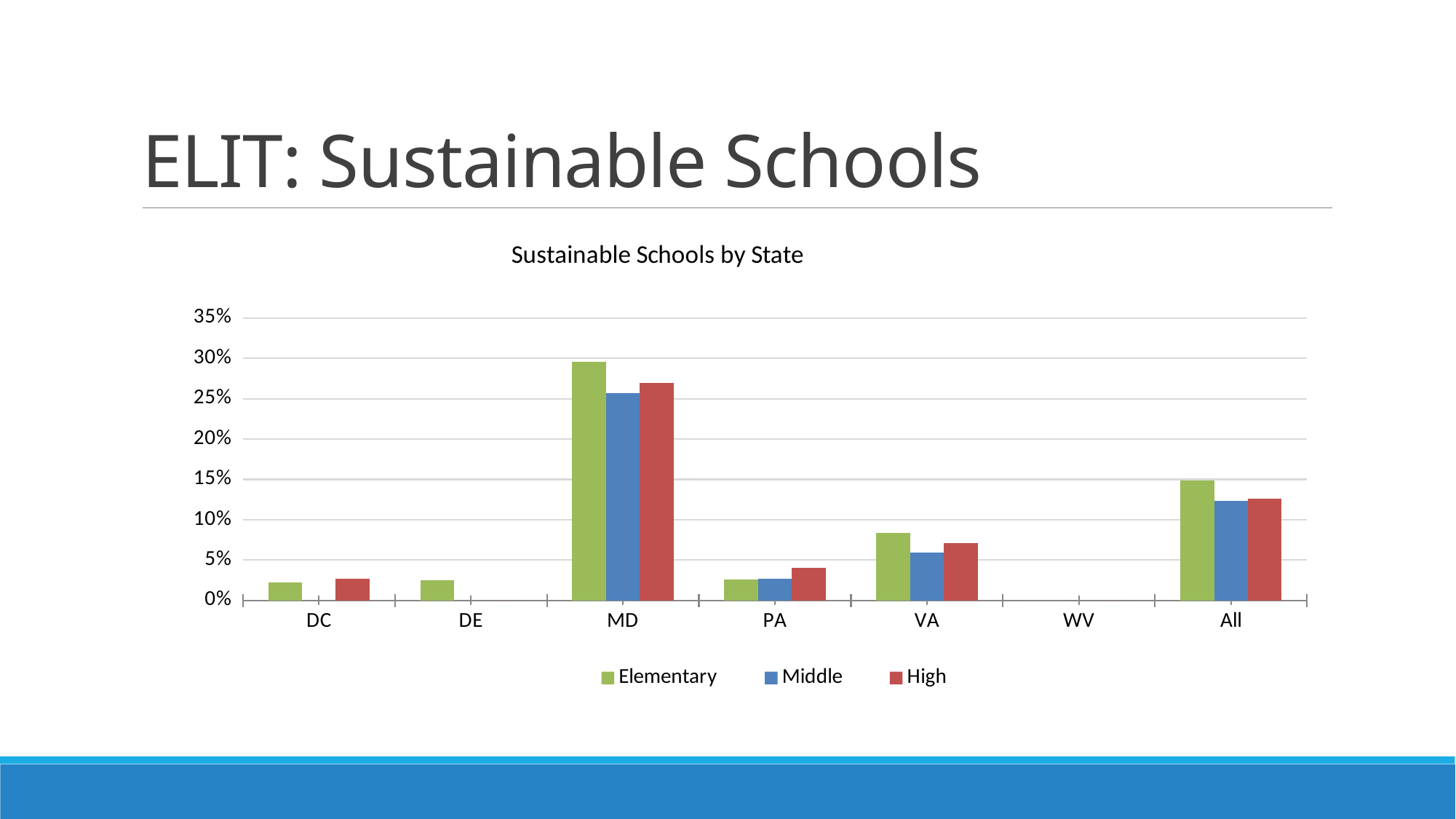
What colour represents the High series in the legend? red What is the title of the chart? Sustainable Schools by State Is the High value for PA greater or less than 5%? less How many series does the legend list? 3 Which category shows no visible bars for any series? WV Is the Elementary value for MD greater or less than 25%? greater Which category has the highest Elementary value? MD What kind of chart is shown on the slide? bar chart Is the Elementary value for All greater or less than 10%? greater For MD, which is larger: the Elementary value or the Middle value? Elementary How many categories are shown on the x axis? 7